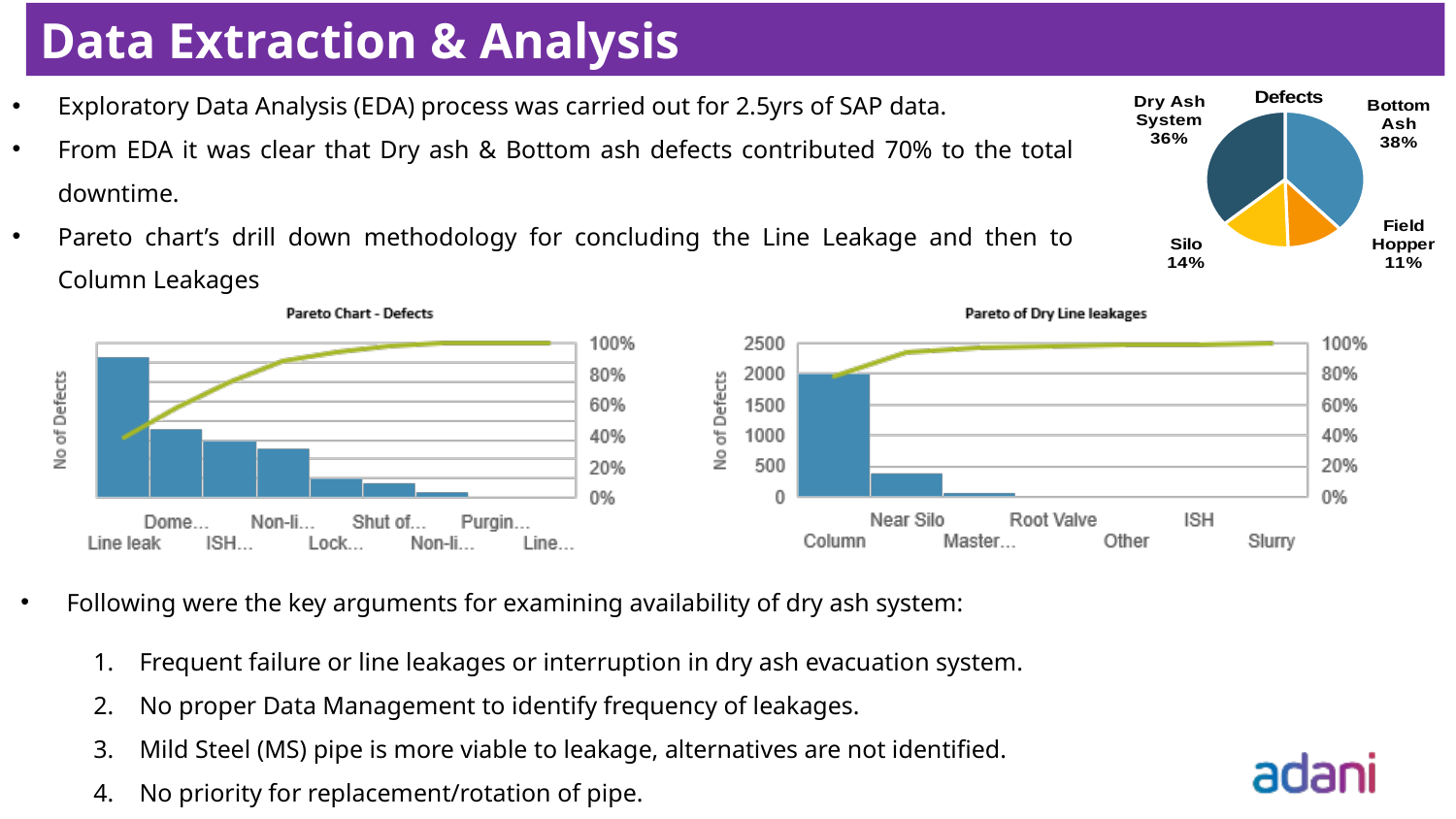
How many slices does the Defects pie chart have? 4 In the Defects pie chart, which category has the largest share? Bottom Ash In the Defects pie chart, which category has the smallest share? Field Hopper In the Defects pie chart, what percentage is shown for Field Hopper? 11% What is the label on the vertical axis of the Pareto Chart - Defects? No of Defects In the Pareto of Dry Line leakages chart, which category has the highest number of defects? Column In the Defects pie chart, what percentage is shown for the Dry Ash System? 36% In the Pareto of Dry Line leakages chart, is the value for Column greater or less than 1500? greater In the Pareto of Dry Line leakages chart, do the bar values rise or fall from left to right along the x axis? fall In the Pareto of Dry Line leakages chart, is the value for Near Silo greater or less than 1000? less In the Defects pie chart, what share of defects is attributed to Bottom Ash? 38% In the Defects pie chart, what is the difference between the Silo share and the Field Hopper share? 3%